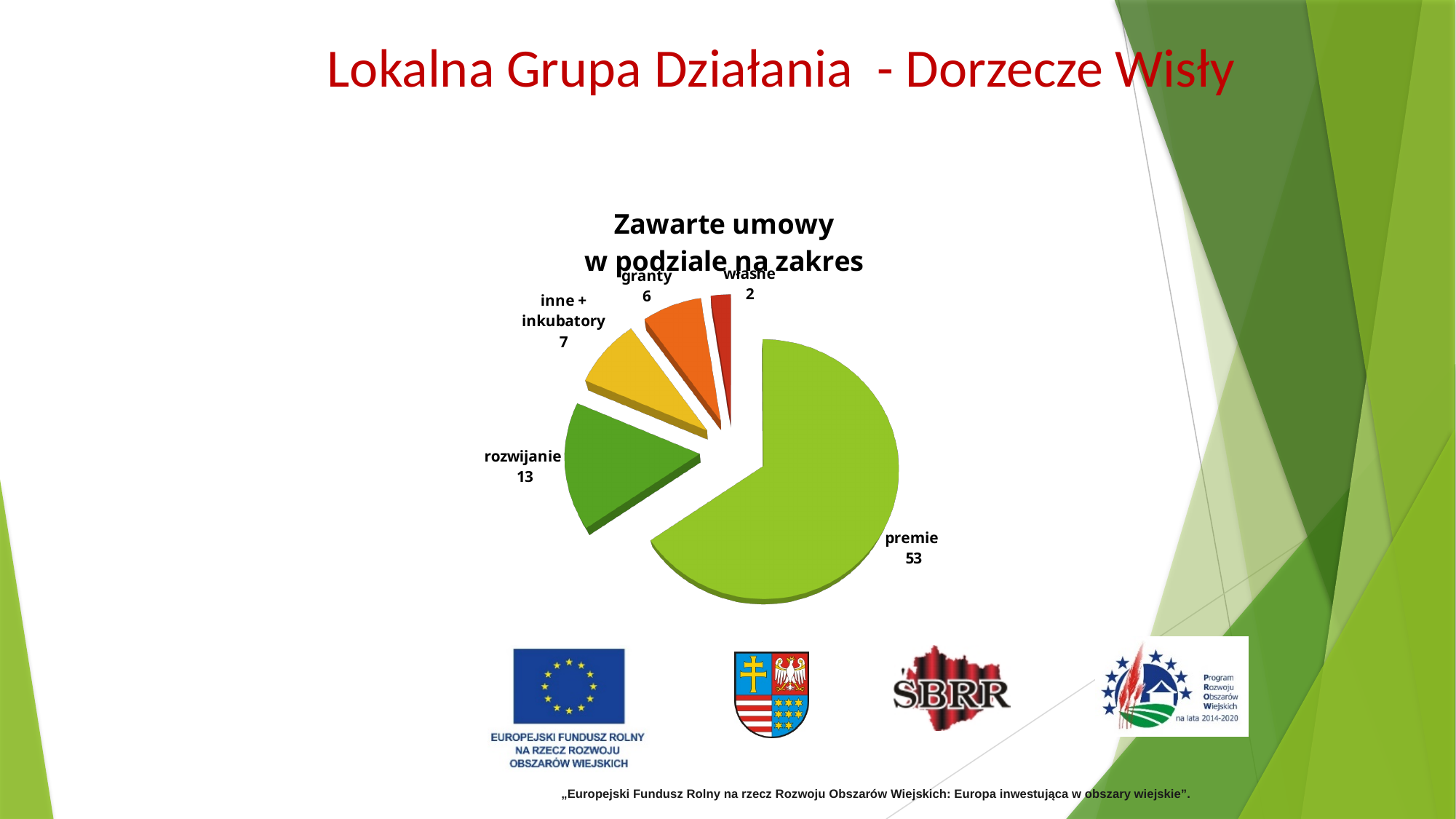
What is the title of the chart? Zawarte umowy w podziale na zakres What is the value for inne + inkubatory? 7 Which is larger, the value for granty or the value for inne + inkubatory? inne + inkubatory What is the value for własne? 2 How many slices does the pie chart have? 5 Which category has the largest slice? premie What type of chart is shown on the slide? pie chart What is the difference between the values for premie and rozwijanie? 40 Which category has the smallest slice? własne What is the value for premie? 53 What is the value for rozwijanie? 13 What is the value for granty? 6